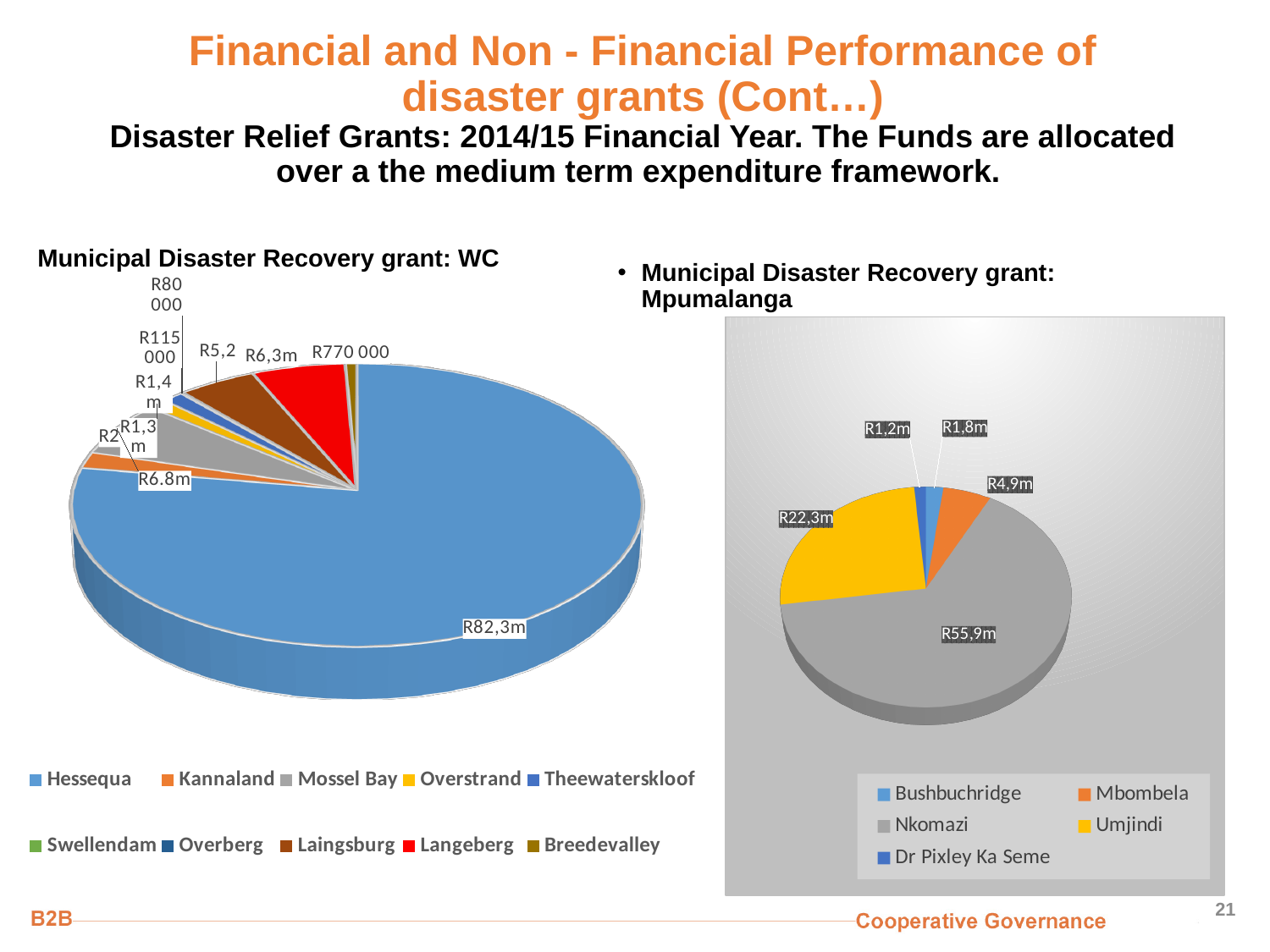
In the 'Municipal Disaster Recovery grant: WC' chart, which municipality has the largest slice? Hessequa In the 'Municipal Disaster Recovery grant: WC' chart, what is the value for Kannaland? R2 In the 'Municipal Disaster Recovery grant: Mpumalanga' chart, what is the value for Mbombela? R4,9m In the 'Municipal Disaster Recovery grant: Mpumalanga' chart, which municipality has the largest slice? Nkomazi In the 'Municipal Disaster Recovery grant: Mpumalanga' chart, what is the difference between the values for Nkomazi and Umjindi? R33,6m How many municipalities are listed in the legend of the 'Municipal Disaster Recovery grant: Mpumalanga' chart? 5 How many municipalities are listed in the legend of the 'Municipal Disaster Recovery grant: WC' chart? 10 In the 'Municipal Disaster Recovery grant: WC' chart, what is the value for Hessequa? R82,3m In the 'Municipal Disaster Recovery grant: WC' chart, which is larger, the value for Hessequa or the value for Kannaland? Hessequa In the 'Municipal Disaster Recovery grant: Mpumalanga' chart, what is the value for Umjindi? R22,3m What kind of chart is the 'Municipal Disaster Recovery grant: WC' chart? pie chart In the 'Municipal Disaster Recovery grant: Mpumalanga' chart, what is the value for Nkomazi? R55,9m